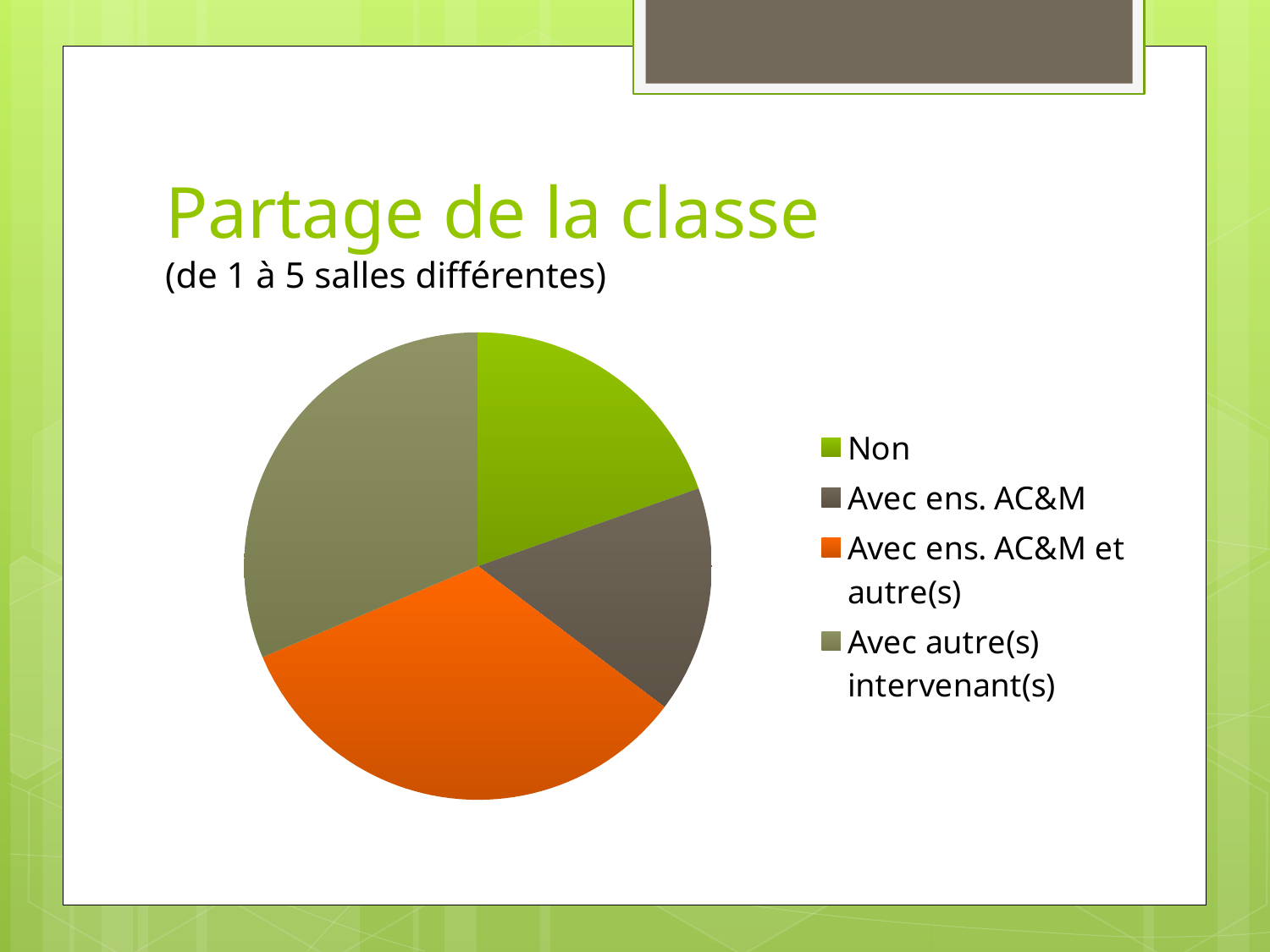
How many entries does the legend of the pie chart list? 4 Which slice is larger: 'Avec ens. AC&M et autre(s)' or 'Non'? Avec ens. AC&M et autre(s) Which slice is the smallest in the pie chart? Avec ens. AC&M Which slice is larger: 'Non' or 'Avec ens. AC&M'? Non Which slice is larger: 'Avec autre(s) intervenant(s)' or 'Avec ens. AC&M'? Avec autre(s) intervenant(s) What is the title of the slide containing the pie chart? Partage de la classe Which legend entry is shown in orange in the pie chart? Avec ens. AC&M et autre(s) What kind of chart is shown on the slide? pie chart How many slices does the pie chart have? 4